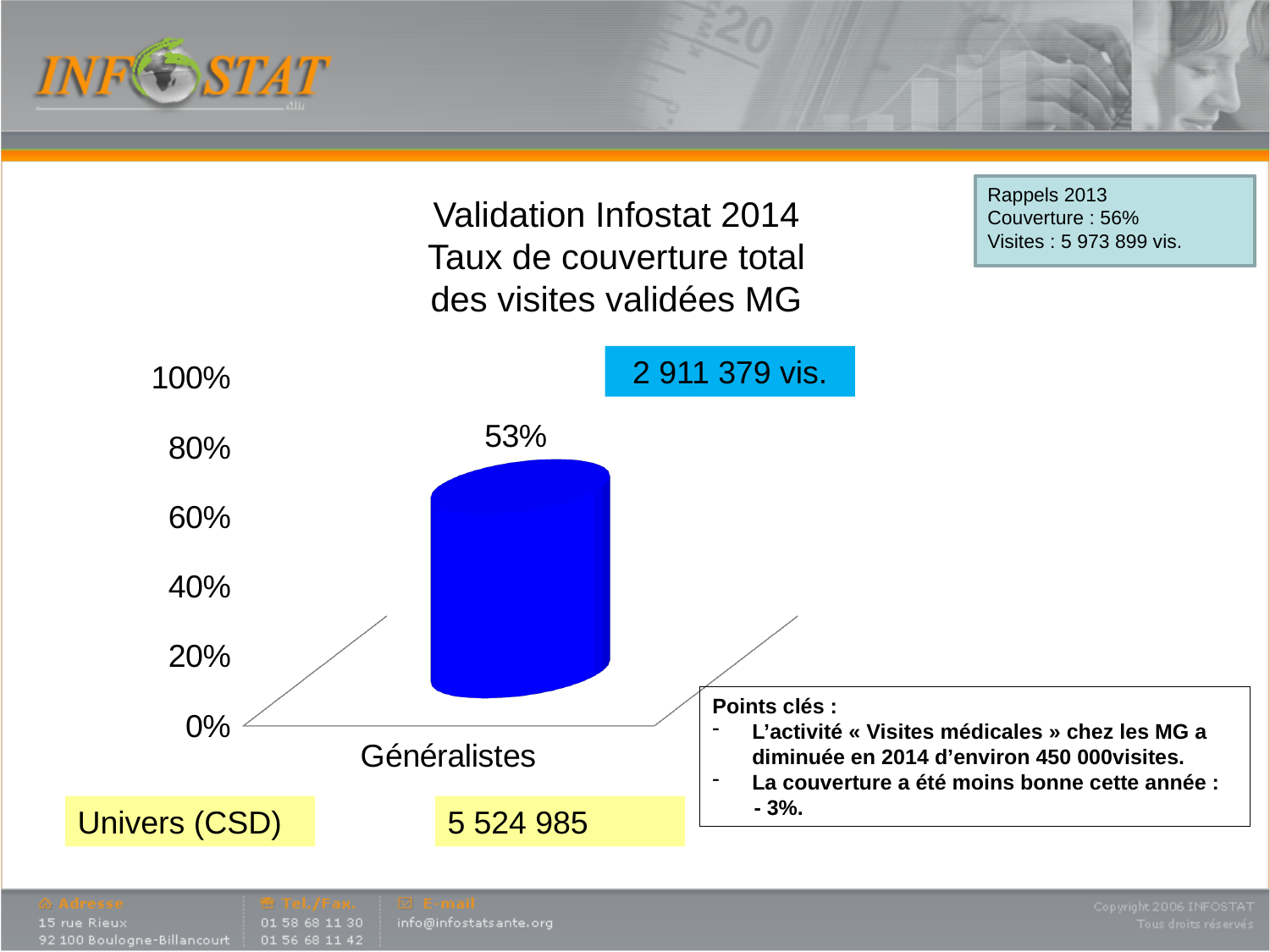
Is the value for Généralistes greater or less than 60%? less What kind of chart is shown on the slide? bar chart Is the value for Généralistes greater or less than 40%? greater What is the value shown for Généralistes in the chart? 53% How many categories are plotted in the chart? 1 What is the label of the category on the x axis of the chart? Généralistes Is the value for Généralistes greater or less than 80%? less What is the highest value shown on the y axis of the chart? 100%